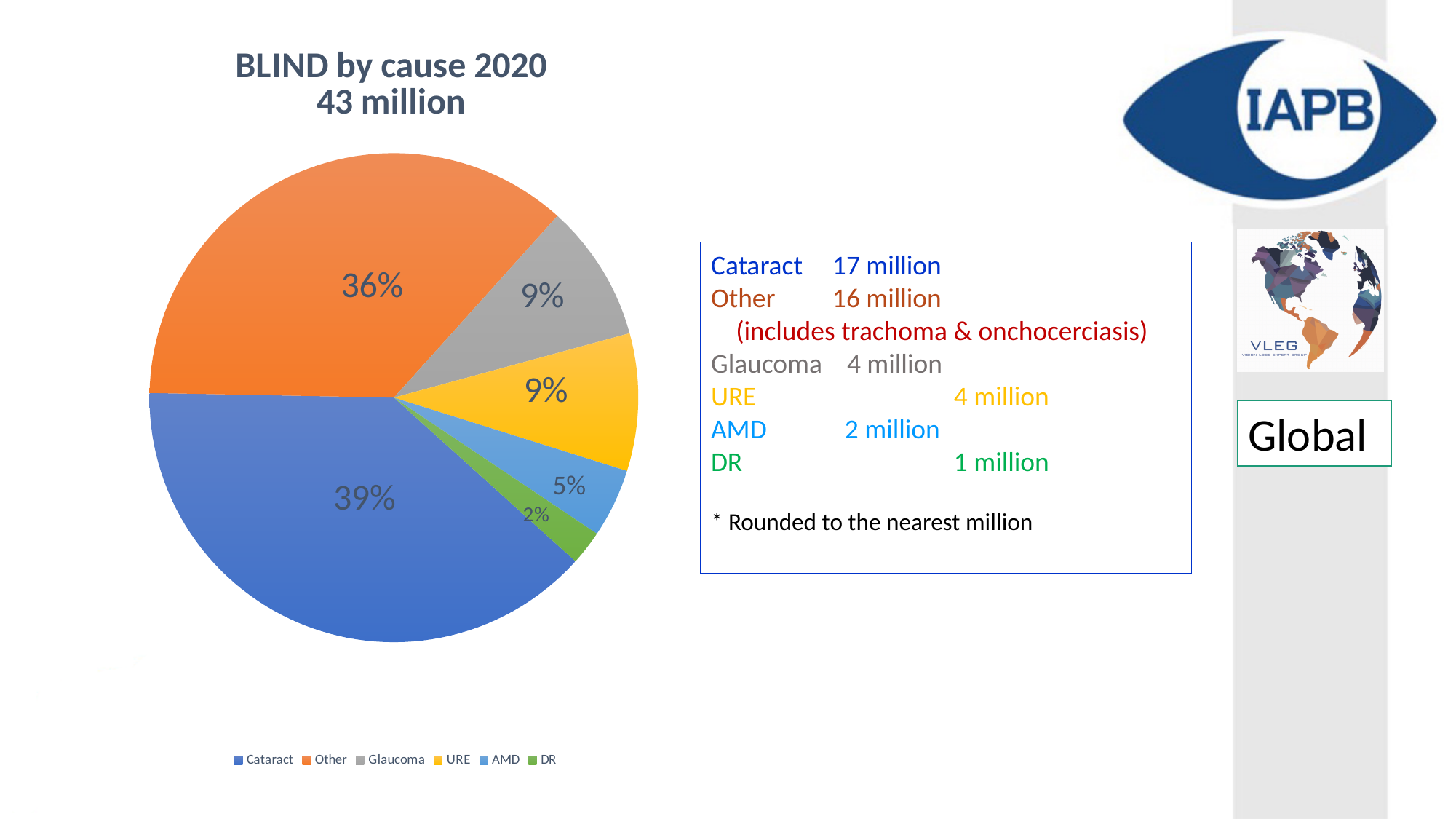
What kind of chart is shown on the slide? pie chart Which cause has the smallest slice of the pie? DR What percentage is shown for the Other slice? 36% What percentage is shown for the DR slice? 2% How many categories does the legend list? 6 Which cause has the largest slice of the pie? Cataract What is the title of the chart? BLIND by cause 2020 43 million By how many percentage points does the Cataract slice exceed the Other slice? 3 percentage points What percentage is shown for the Glaucoma slice? 9% What share of the pie does Cataract account for? 39% What percentage is shown for the AMD slice? 5% Which slice is larger, AMD or DR? AMD